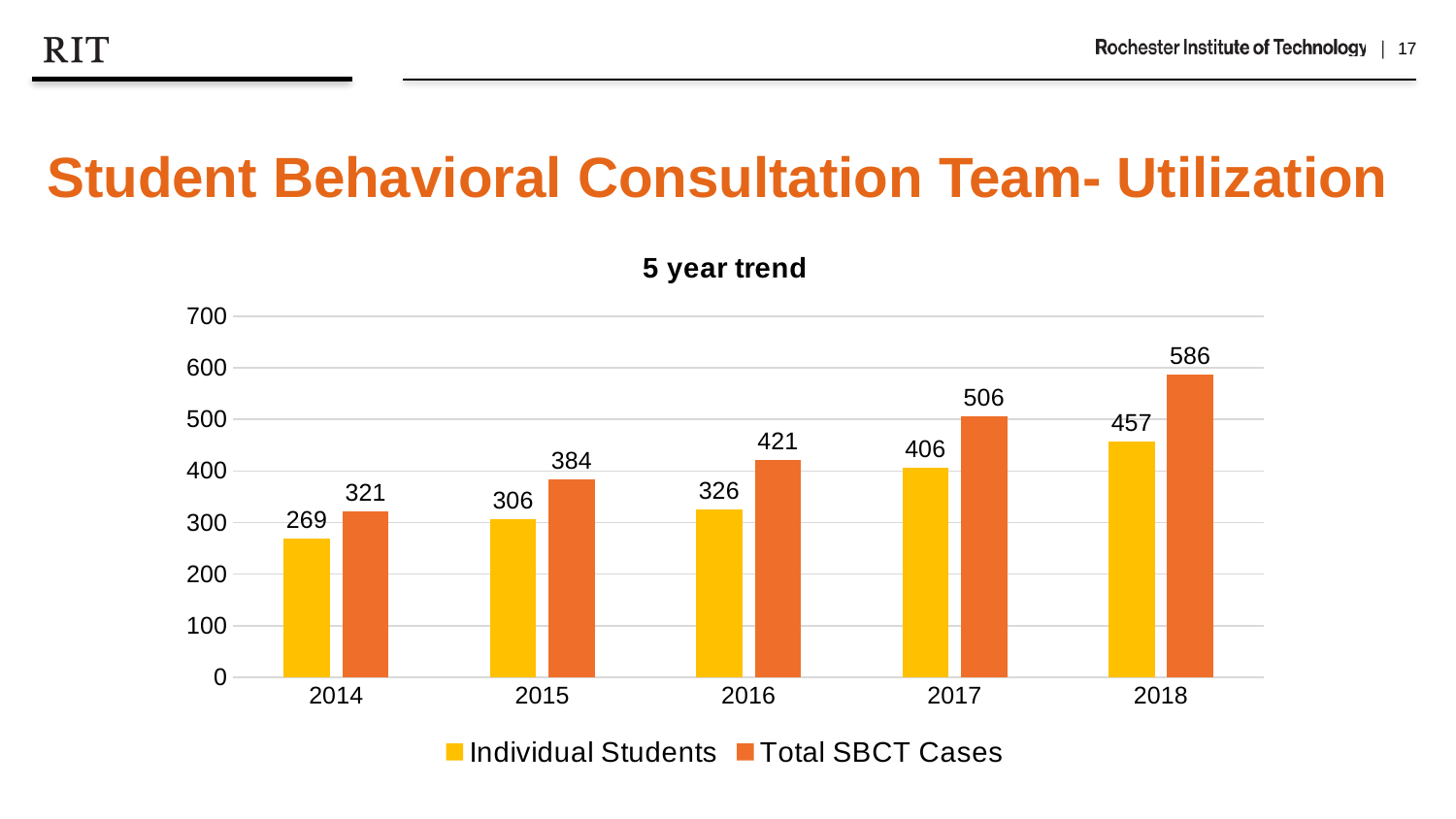
What is the value for Total SBCT Cases in 2018? 586 What kind of chart is shown on the slide? Bar chart What is the value for Total SBCT Cases in 2016? 421 Which year has the highest value for Total SBCT Cases? 2018 What is the difference between Total SBCT Cases and Individual Students in 2017? 100 Do the values for Total SBCT Cases rise or fall from 2014 to 2018? Rise What is the difference between Individual Students in 2018 and Individual Students in 2014? 188 What is the value for Individual Students in 2014? 269 How many series does the legend list? 2 Which is larger: Individual Students in 2016 or Total SBCT Cases in 2015? Total SBCT Cases in 2015 How many years are shown on the x axis? 5 Which year has the lowest value for Individual Students? 2014